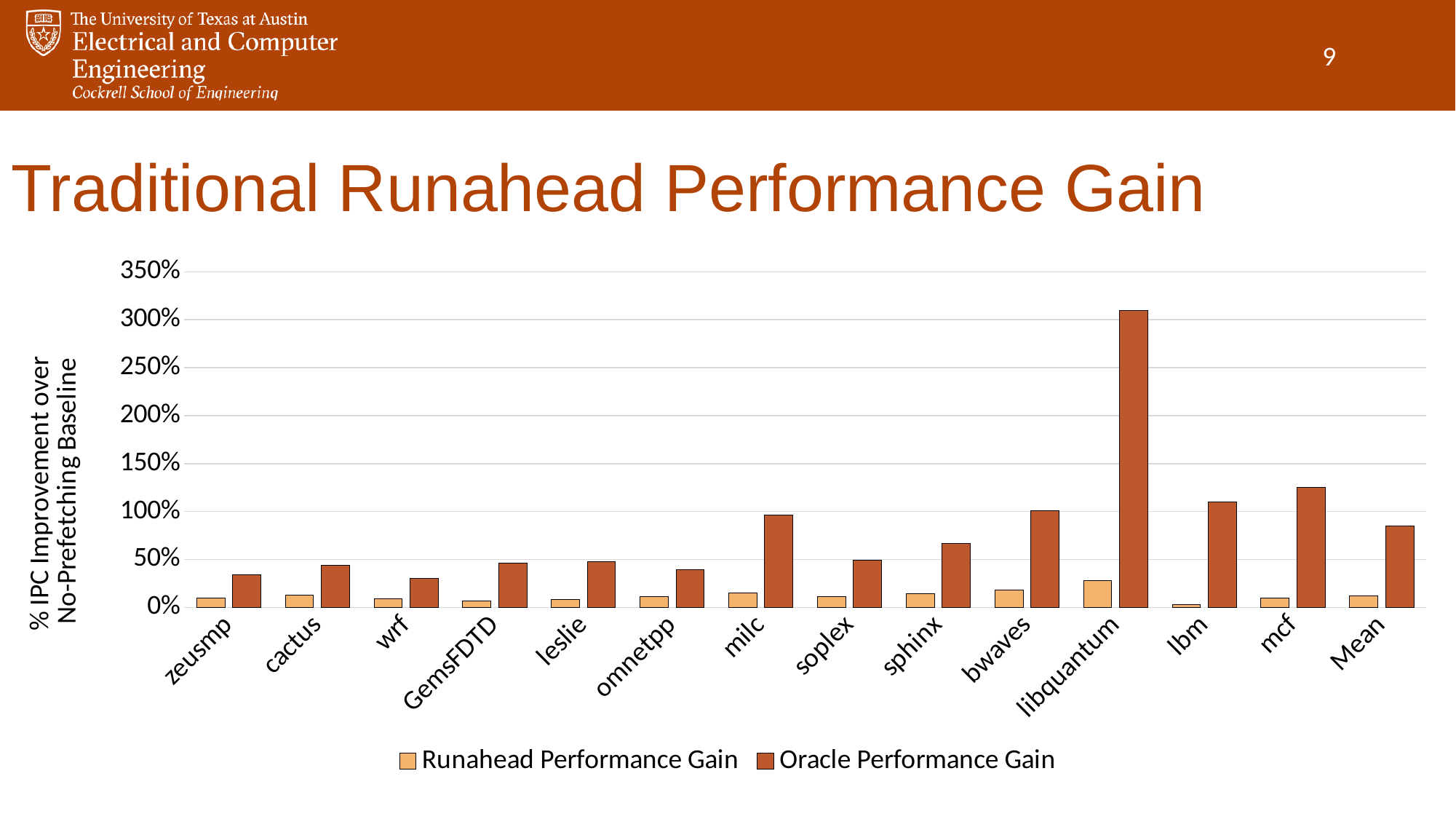
Which is larger, the Oracle Performance Gain for milc or for soplex? milc Which is larger, the Runahead Performance Gain for libquantum or for bwaves? libquantum What kind of chart is shown on the slide? bar chart Which category has the highest Runahead Performance Gain? libquantum Is the Oracle Performance Gain for libquantum greater or less than 250%? greater Is the Oracle Performance Gain for Mean greater or less than 100%? less Which category has the highest Oracle Performance Gain? libquantum How many categories are shown on the x axis? 14 Which category has the lowest Runahead Performance Gain? lbm What is the label of the y axis? % IPC Improvement over No-Prefetching Baseline Is the Oracle Performance Gain for sphinx greater or less than 50%? greater How many series does the legend list? 2